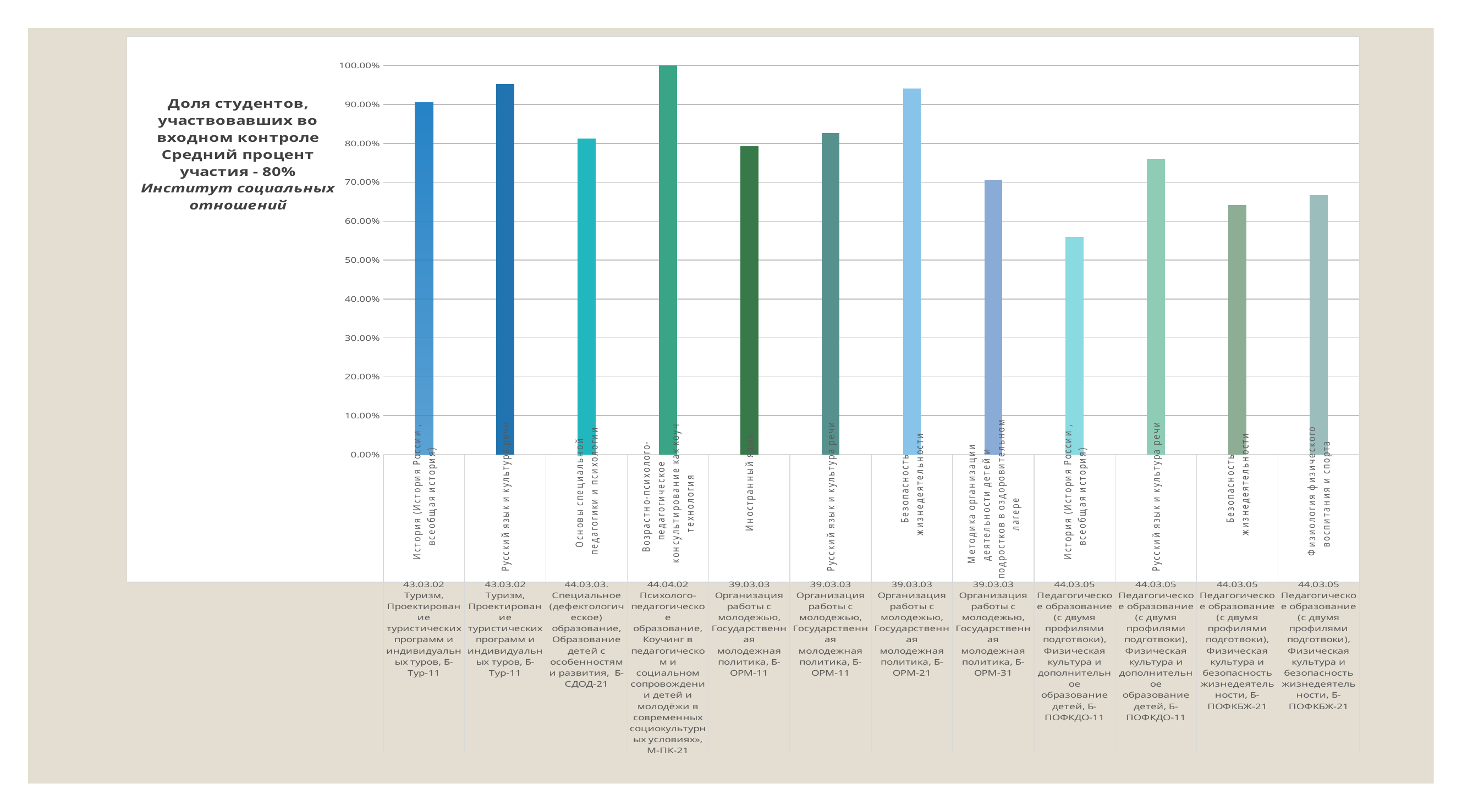
Which institute does the chart title refer to? Институт социальных отношений According to the chart title, what is the average participation percentage? 80% Which is larger: the value for Русский язык и культура речи in group Б-Тур-11 or in group Б-ОРМ-11? Б-Тур-11 Which discipline has the lowest share of students who took part in the entrance control? История (История России, всеобщая история), Б-ПОФКДО-11 Is the value for Методика организации деятельности детей и подростков в оздоровительном лагере (Б-ОРМ-31) greater or less than 80.00%? less How many bars (disciplines) are plotted in the chart? 12 Which is larger: the value for Иностранный язык (Б-ОРМ-11) or the value for Физиология физического воспитания и спорта (Б-ПОФКБЖ-21)? Иностранный язык (Б-ОРМ-11) Which discipline has the highest share of students who took part in the entrance control? Возрастно-психолого-педагогическое консультирование как коуч технология (М-ПК-21) What kind of chart is shown on the slide? bar chart What is the value for Возрастно-психолого-педагогическое консультирование как коуч технология (М-ПК-21)? 100.00% Is the value for Безопасность жизнедеятельности in group Б-ОРМ-21 greater or less than 90.00%? greater Is the value for История (История России, всеобщая история) in group Б-ПОФКДО-11 greater or less than 60.00%? less